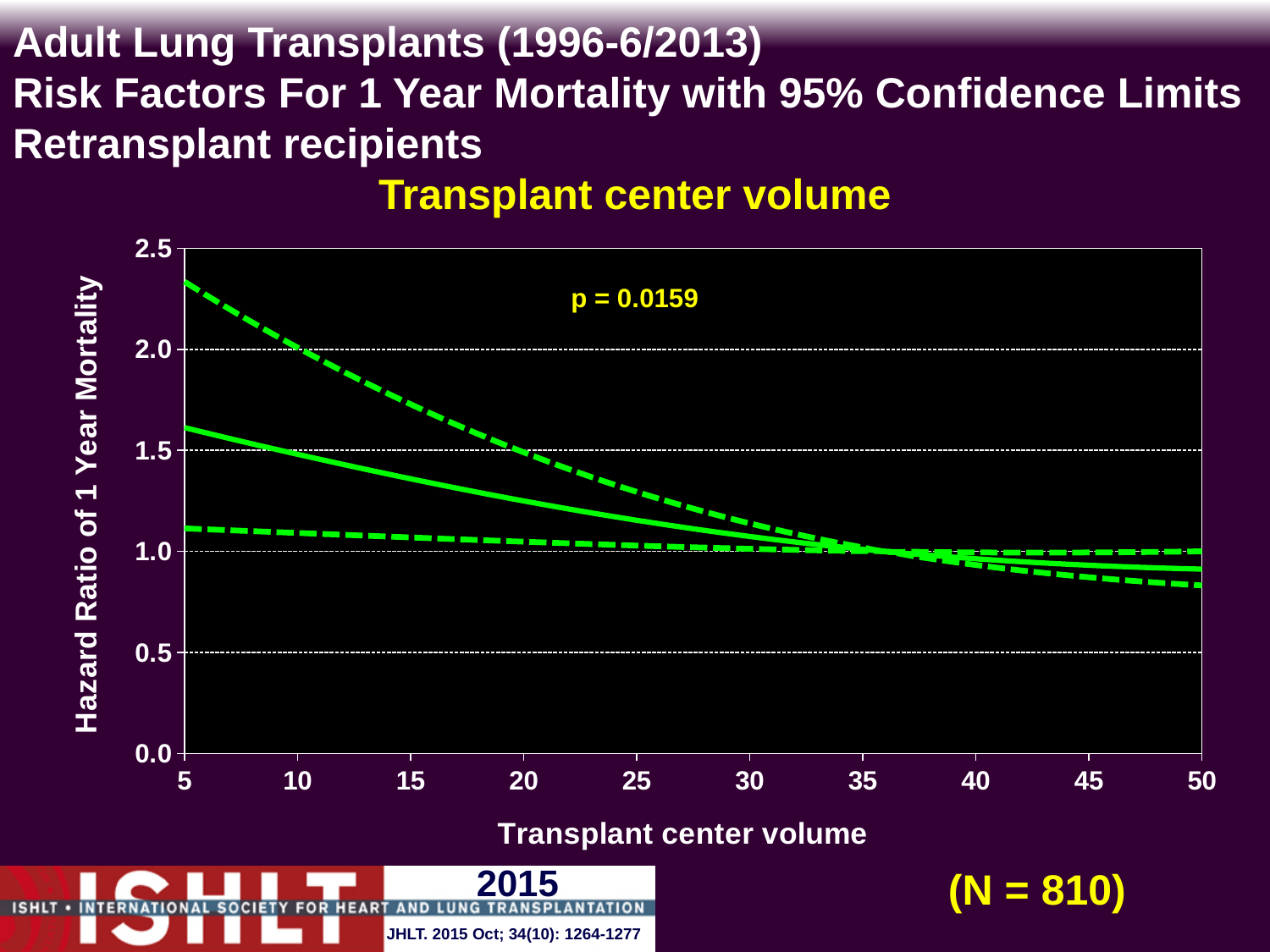
Is the solid hazard ratio line at a transplant center volume of 30 greater or less than 1.5? less What is the highest value shown on the y axis? 2.5 What p-value is printed on the chart? p = 0.0159 What kind of chart is shown on the slide? line chart What is the highest value shown on the x axis? 50 Does the solid hazard ratio line rise or fall as transplant center volume increases from 5 to 50? fall Is the solid hazard ratio line at a transplant center volume of 10 greater or less than 1.0? greater Is the upper dashed confidence limit at a transplant center volume of 5 greater or less than 2.0? greater What is the label of the y axis? Hazard Ratio of 1 Year Mortality How many lines are plotted on the chart? 3